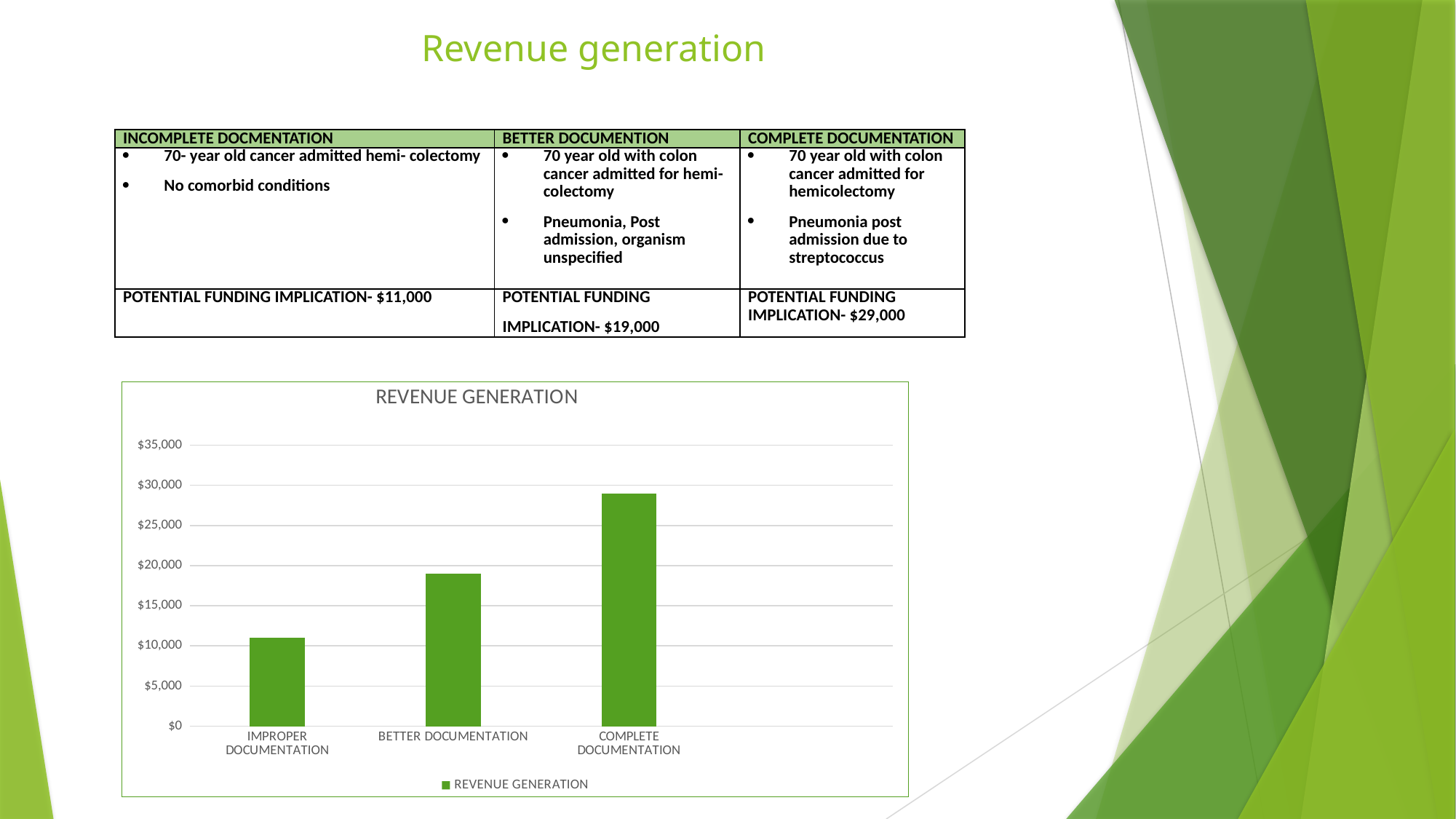
Which is larger, the value for BETTER DOCUMENTATION or the value for IMPROPER DOCUMENTATION? BETTER DOCUMENTATION What is the title of the chart? REVENUE GENERATION Do the values rise or fall from left to right across the categories? rise How many series does the chart legend list? 1 What type of chart is shown on the slide? bar chart Which category has the highest bar in the chart? COMPLETE DOCUMENTATION Is the value for BETTER DOCUMENTATION greater or less than $15,000? greater Which category has the lowest bar in the chart? IMPROPER DOCUMENTATION Is the value for COMPLETE DOCUMENTATION greater or less than $25,000? greater Is the value for IMPROPER DOCUMENTATION greater or less than $15,000? less How many categories are shown on the x axis of the chart? 3